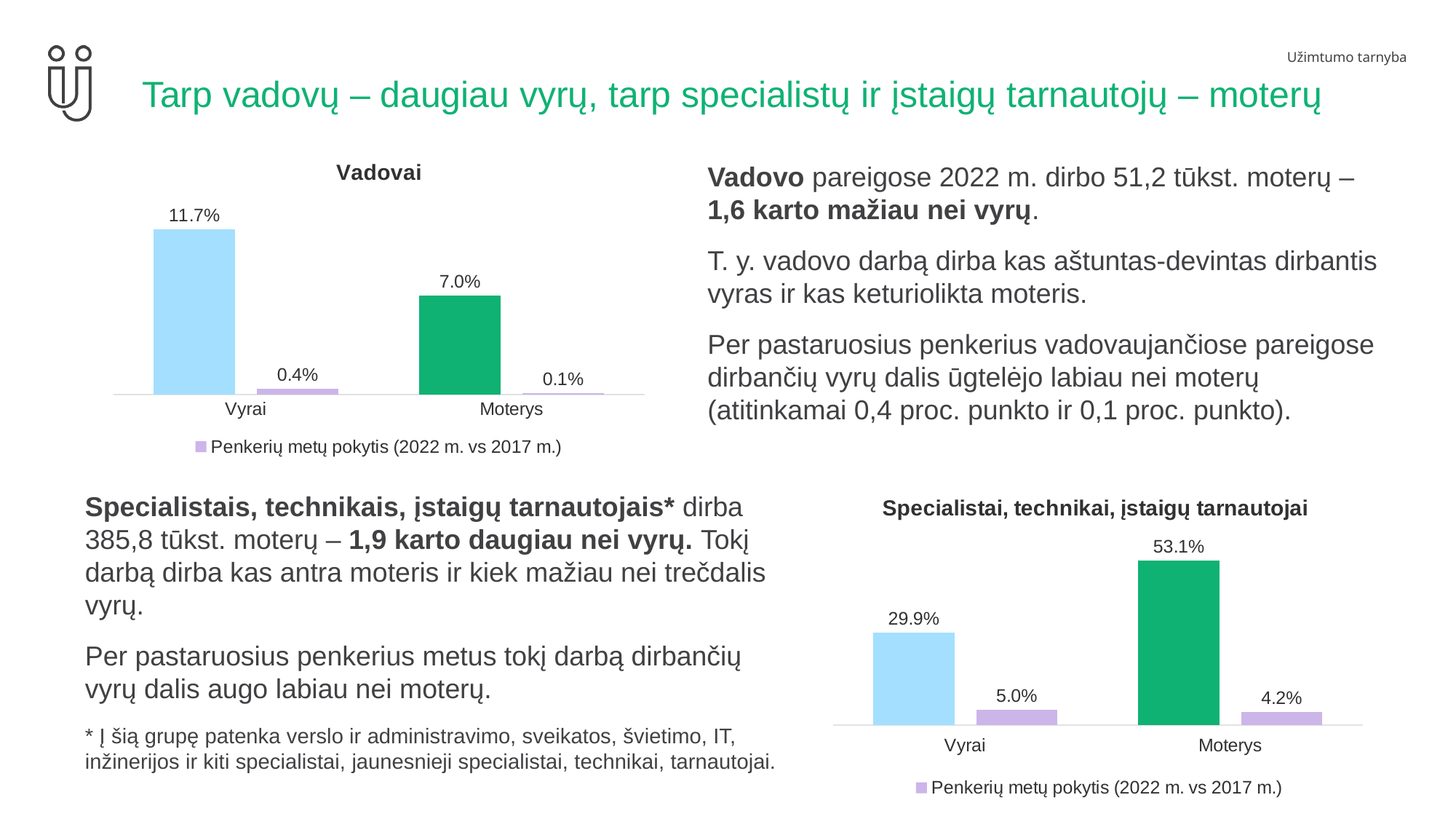
In the 'Specialistai, technikai, įstaigų tarnautojai' chart, what is the value shown for Vyrai? 29.9% In the 'Specialistai, technikai, įstaigų tarnautojai' chart, what is the five-year change (Penkerių metų pokytis) for Vyrai? 5.0% In the 'Specialistai, technikai, įstaigų tarnautojai' chart, which category has the higher main value, Vyrai or Moterys? Moterys In the 'Vadovai' chart, what is the value shown for Moterys? 7.0% What type of chart is the 'Vadovai' chart? Bar chart In the 'Vadovai' chart, what is the five-year change (Penkerių metų pokytis) for Vyrai? 0.4% In the 'Specialistai, technikai, įstaigų tarnautojai' chart, what is the difference between the Moterys and Vyrai values? 23.2% In the 'Vadovai' chart, what is the difference between the Vyrai and Moterys values? 4.7% In the 'Specialistai, technikai, įstaigų tarnautojai' chart, what is the value shown for Moterys? 53.1% In the 'Vadovai' chart, what is the value shown for Vyrai? 11.7% How many categories are shown on the x axis of the 'Specialistai, technikai, įstaigų tarnautojai' chart? 2 In the 'Vadovai' chart, what is the five-year change (Penkerių metų pokytis) for Moterys? 0.1%